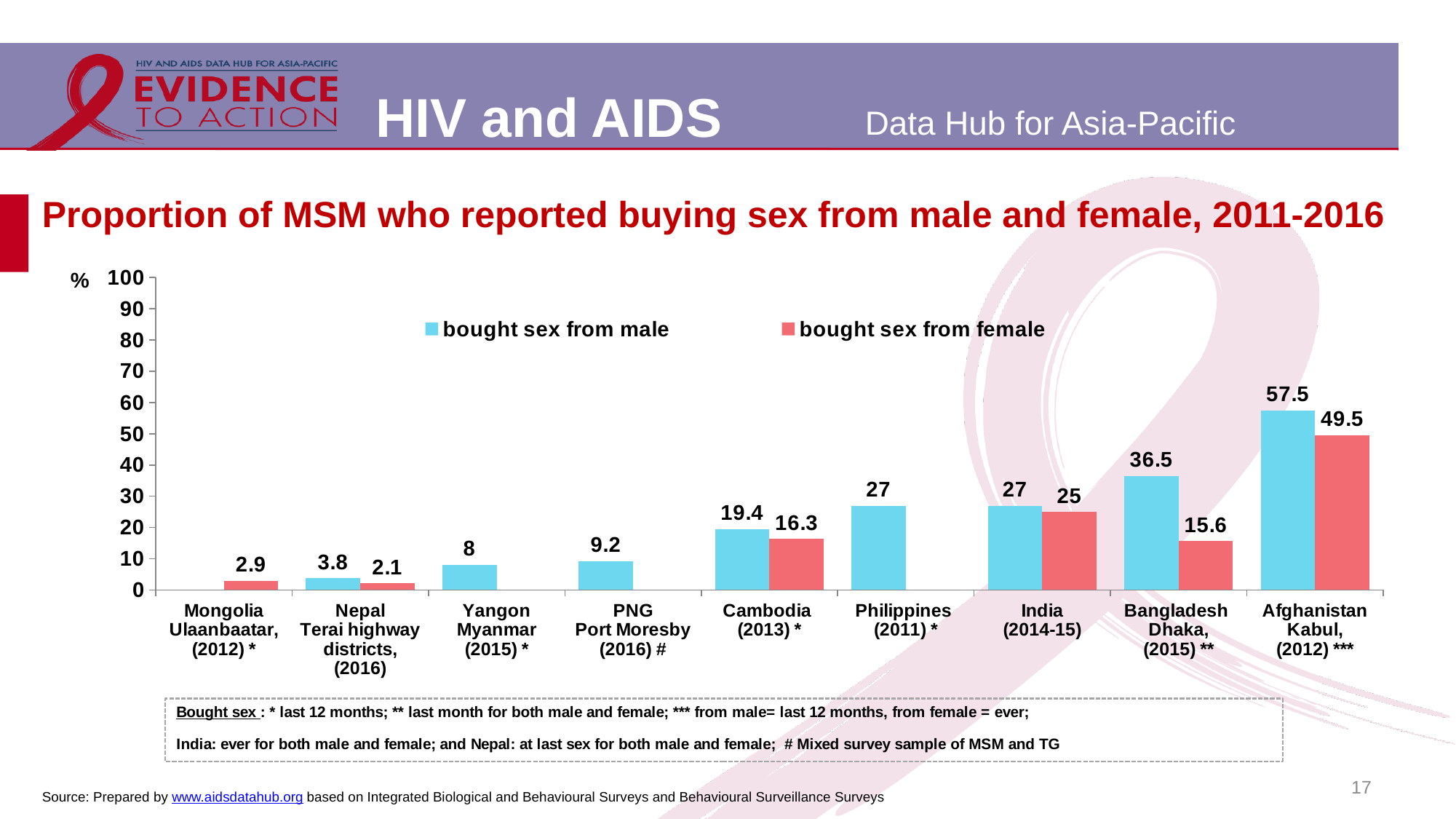
What is the difference between 'bought sex from male' and 'bought sex from female' in Afghanistan Kabul (2012)? 8 What is the value for 'bought sex from male' in Afghanistan Kabul (2012)? 57.5 How many locations are shown on the x axis of the chart? 9 In India (2014-15), which is larger: 'bought sex from male' or 'bought sex from female'? bought sex from male How many series does the legend list? 2 Which location has the highest value for 'bought sex from male'? Afghanistan Kabul (2012) What is the value for 'bought sex from male' in PNG Port Moresby (2016)? 9.2 What is the value for 'bought sex from female' in Cambodia (2013)? 16.3 Which location has the lowest value for 'bought sex from female'? Nepal Terai highway districts (2016) What is the difference between 'bought sex from male' and 'bought sex from female' in Bangladesh Dhaka (2015)? 20.9 What kind of chart is shown on the slide? bar chart Is the value for 'bought sex from male' in Bangladesh Dhaka (2015) greater or less than 30? greater